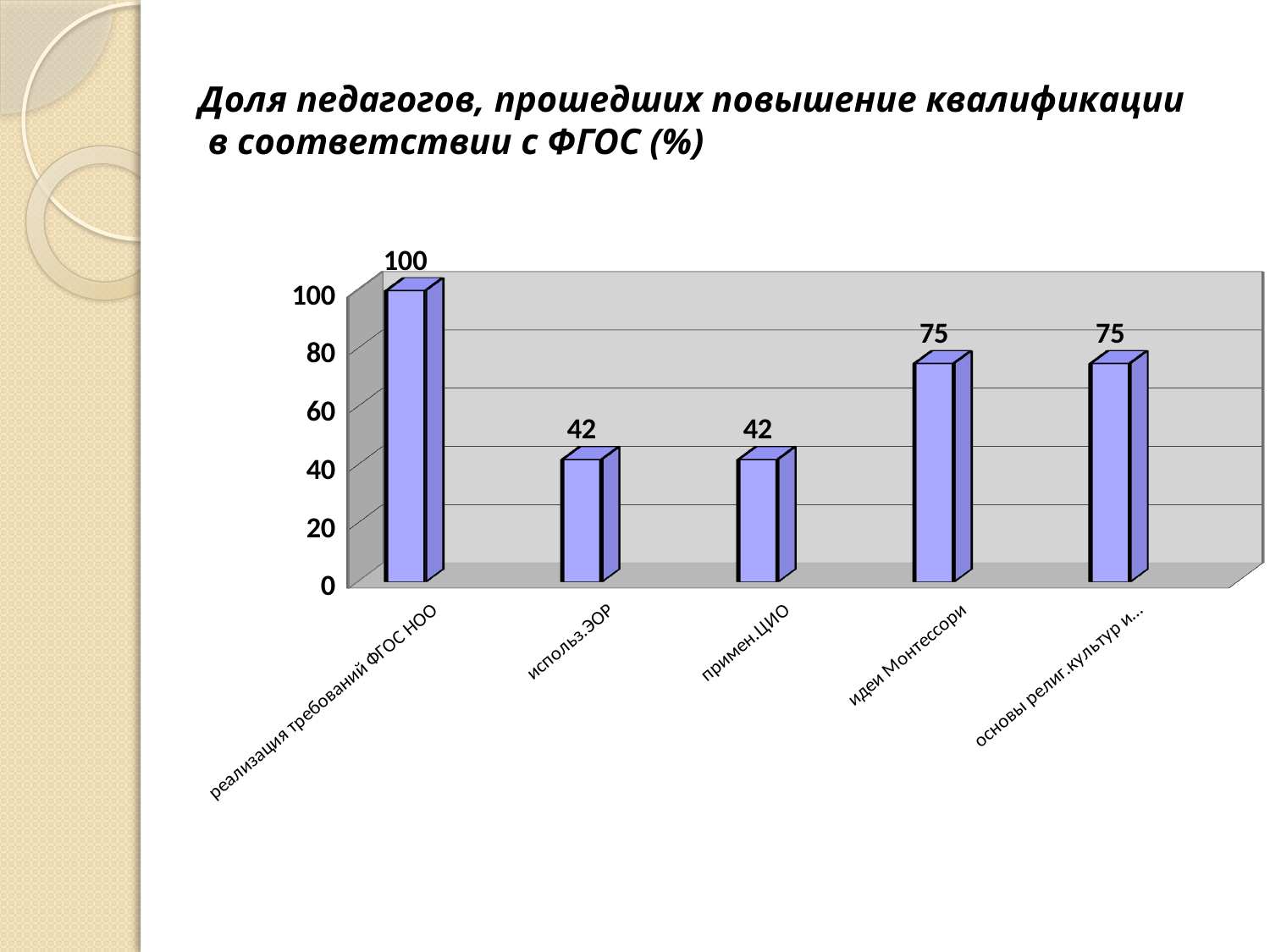
What is the highest value shown on the vertical axis? 100 What is the value for использ.ЭОР? 42 What is the difference between the values for идеи Монтессори and примен.ЦИО? 33 What is the difference between the values for реализация требований ФГОС НОО and идеи Монтессори? 25 What kind of chart is shown on the slide? bar chart Is the value for примен.ЦИО greater or less than 60? less Which category has the highest value? реализация требований ФГОС НОО Which is larger, the value for примен.ЦИО or the value for идеи Монтессори? идеи Монтессори How many categories are shown in the chart? 5 What is the value for идеи Монтессори? 75 What is the value for реализация требований ФГОС НОО? 100 What is the title of the chart? Доля педагогов, прошедших повышение квалификации в соответствии с ФГОС (%)